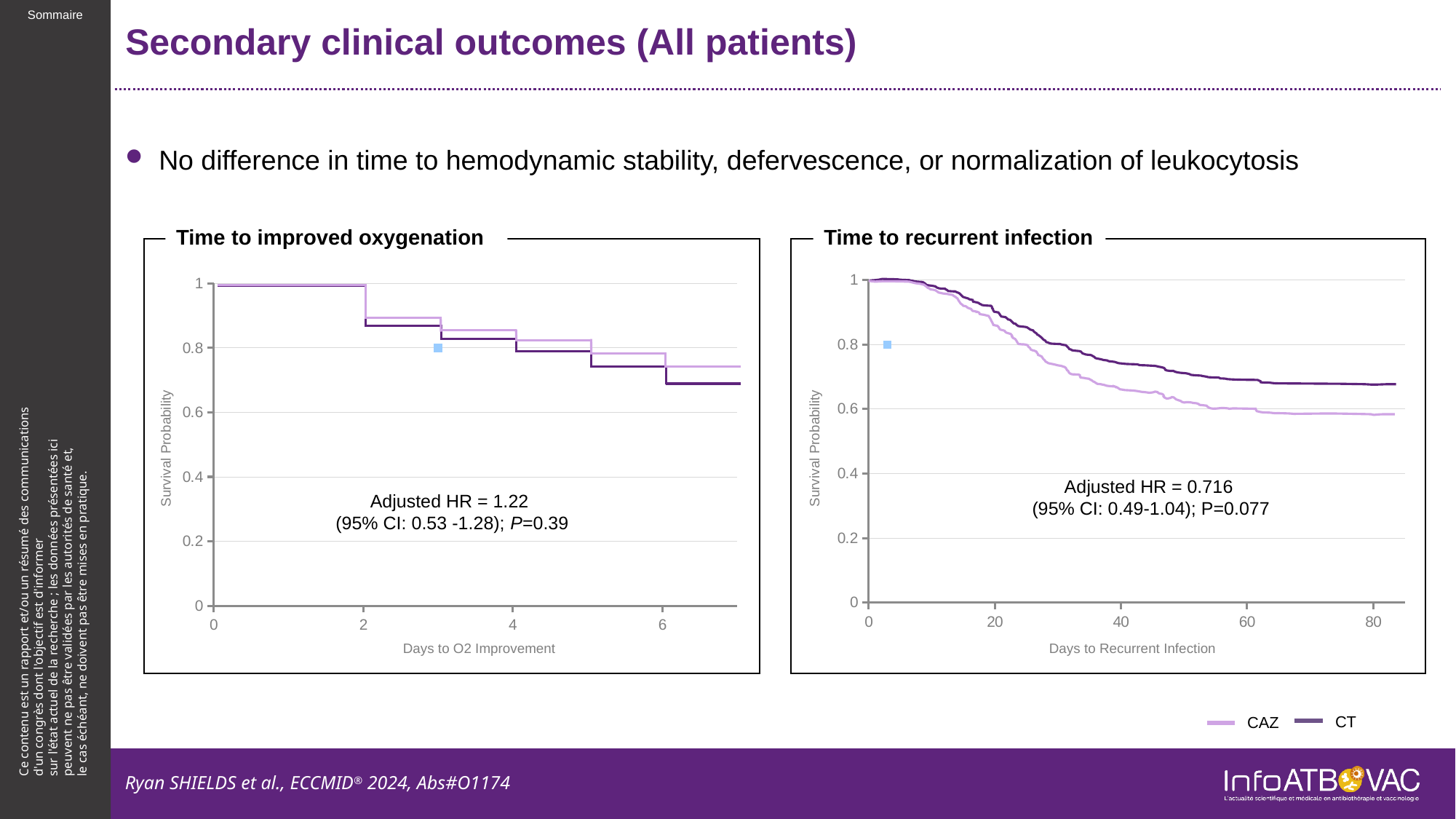
What adjusted hazard ratio is shown on the "Time to recurrent infection" chart? 0.716 In the "Time to recurrent infection" chart, which series has the higher survival probability at day 80, CAZ or CT? CT In the "Time to recurrent infection" chart, what is the highest value labelled on the x axis? 80 In the "Time to improved oxygenation" chart, is the CT survival probability at day 6 greater or less than 0.8? less How many series does the legend list for the charts? 2 In the "Time to recurrent infection" chart, is the CAZ survival probability at day 80 greater or less than 0.8? less What kind of chart is the "Time to improved oxygenation" chart? line chart In the "Time to recurrent infection" chart, is the CT survival probability at day 80 greater or less than 0.8? less What is the P value shown on the "Time to improved oxygenation" chart? 0.39 In the "Time to improved oxygenation" chart, which series has the higher survival probability at day 6, CAZ or CT? CAZ In the "Time to improved oxygenation" chart, what is the survival probability for both series at day 0? 1 In the "Time to recurrent infection" chart, do the survival probability curves rise or fall as days increase? fall